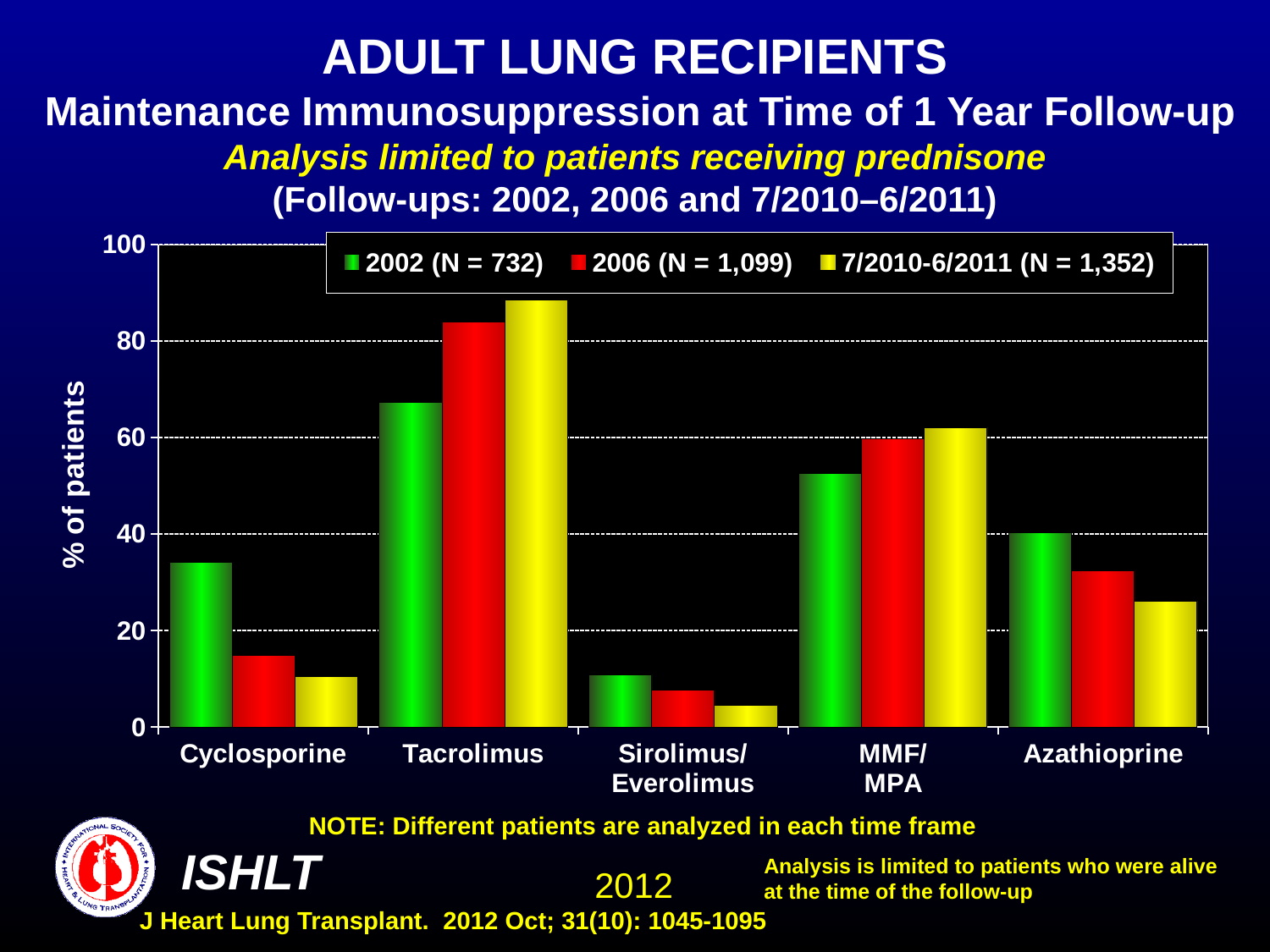
Is the value for Cyclosporine in 2002 greater or less than 40? less How many series does the legend list? 3 Do the Tacrolimus bars rise or fall from 2002 to 7/2010-6/2011? rise What is the label on the y axis? % of patients In 2002, which is larger: the value for Tacrolimus or the value for MMF/MPA? Tacrolimus Is the value for Azathioprine in 7/2010-6/2011 greater or less than 20? greater Which drug has the highest bar for the 7/2010-6/2011 series? Tacrolimus Do the Cyclosporine bars rise or fall from 2002 to 7/2010-6/2011? fall What kind of chart is shown on the slide? bar chart Is the value for Tacrolimus in 2006 greater or less than 80? greater Which drug has the lowest bar for the 2002 series? Sirolimus/Everolimus How many drug categories are shown on the x axis? 5